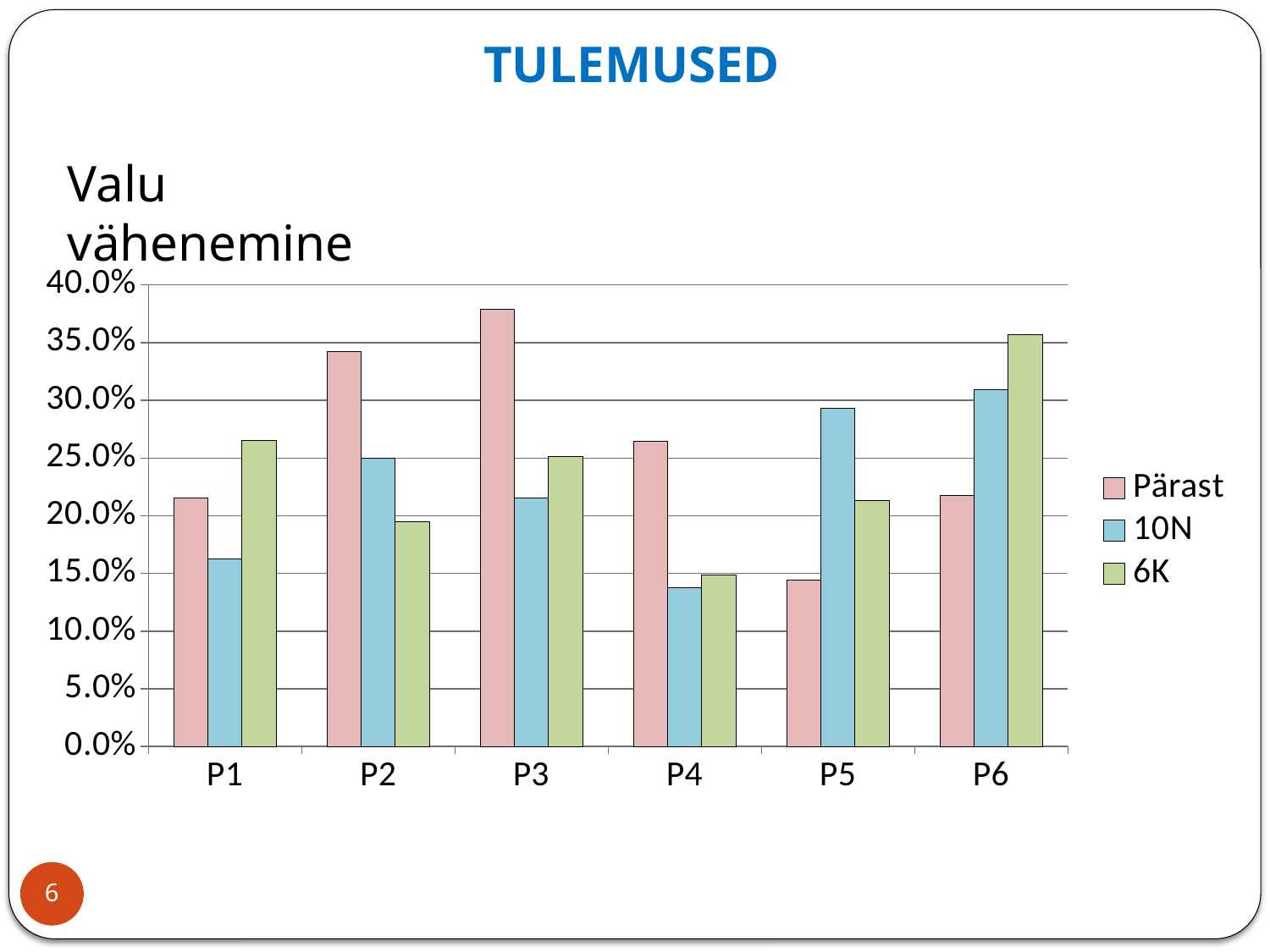
Is the 6K value for P6 greater or less than 35.0%? greater Which category has the highest value for the 10N series? P6 Is the Pärast value for P3 greater or less than 35.0%? greater For P5, which is larger: the Pärast value or the 10N value? 10N What kind of chart is shown on the slide? bar chart How many series does the legend list? 3 Is the 10N value for P4 greater or less than 15.0%? less Which category has the lowest value for the 6K series? P4 What is the title of the chart? Valu vähenemine Which category has the highest value for the Pärast series? P3 How many categories are shown on the x axis? 6 Which category has the lowest value for the Pärast series? P5